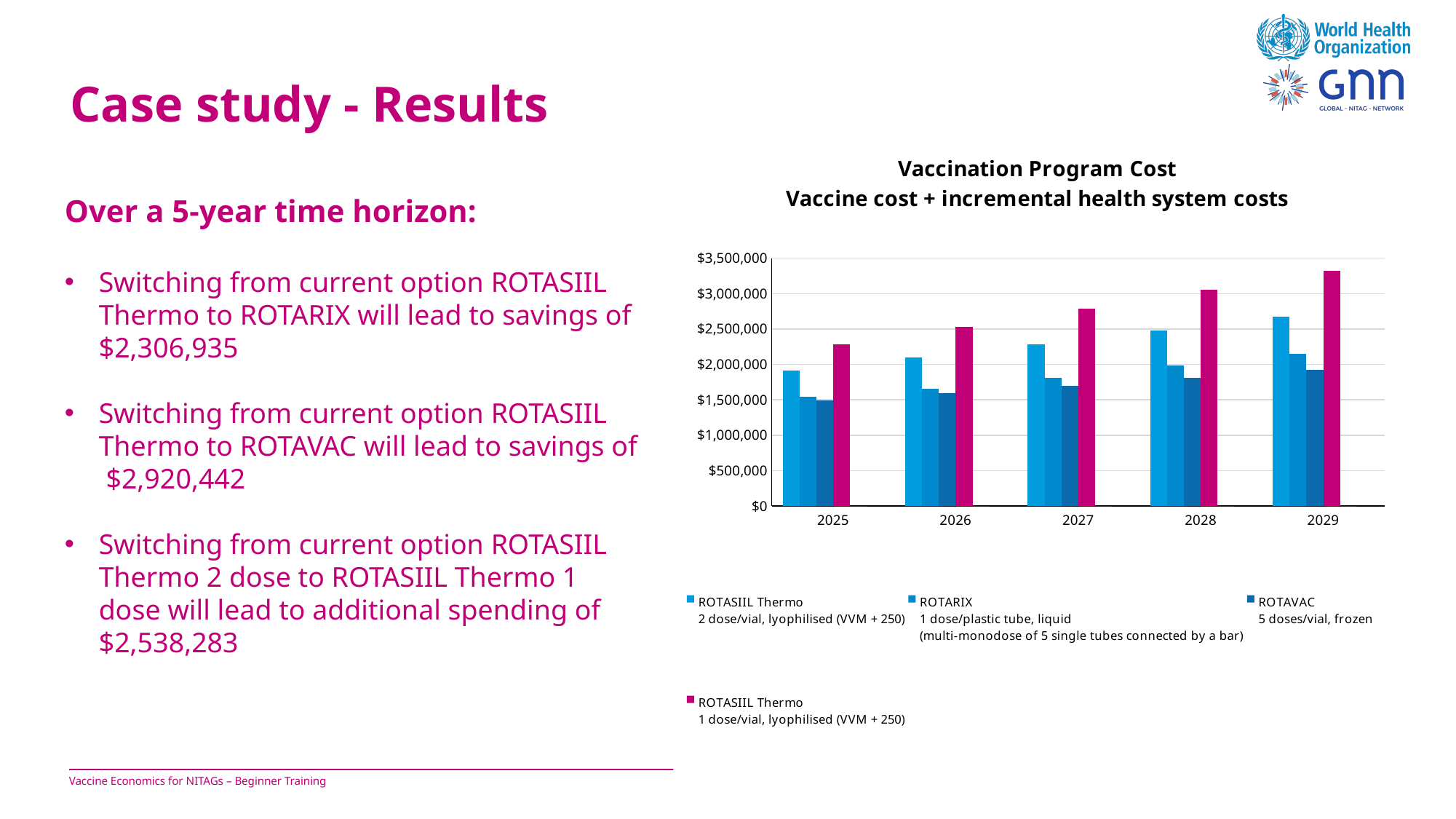
How many years are shown on the x axis of the chart? 5 Which series is shown in magenta in the chart? ROTASIIL Thermo 1 dose/vial, lyophilised (VVM + 250) Which is larger in 2027: the cost for ROTARIX or the cost for ROTASIIL Thermo 2 dose/vial? ROTASIIL Thermo 2 dose/vial Which series has the lowest cost in 2025? ROTAVAC 5 doses/vial, frozen How many series does the chart's legend list? 4 Do the costs for ROTASIIL Thermo 1 dose/vial rise or fall from 2025 to 2029? rise Is the value for ROTASIIL Thermo 2 dose/vial in 2025 greater or less than $2,000,000? less What kind of chart is shown on the slide? bar chart What is the title of the chart? Vaccination Program Cost Vaccine cost + incremental health system costs Is the value for ROTASIIL Thermo 1 dose/vial in 2028 greater or less than $3,000,000? greater Which series has the highest cost in 2029? ROTASIIL Thermo 1 dose/vial, lyophilised (VVM + 250)